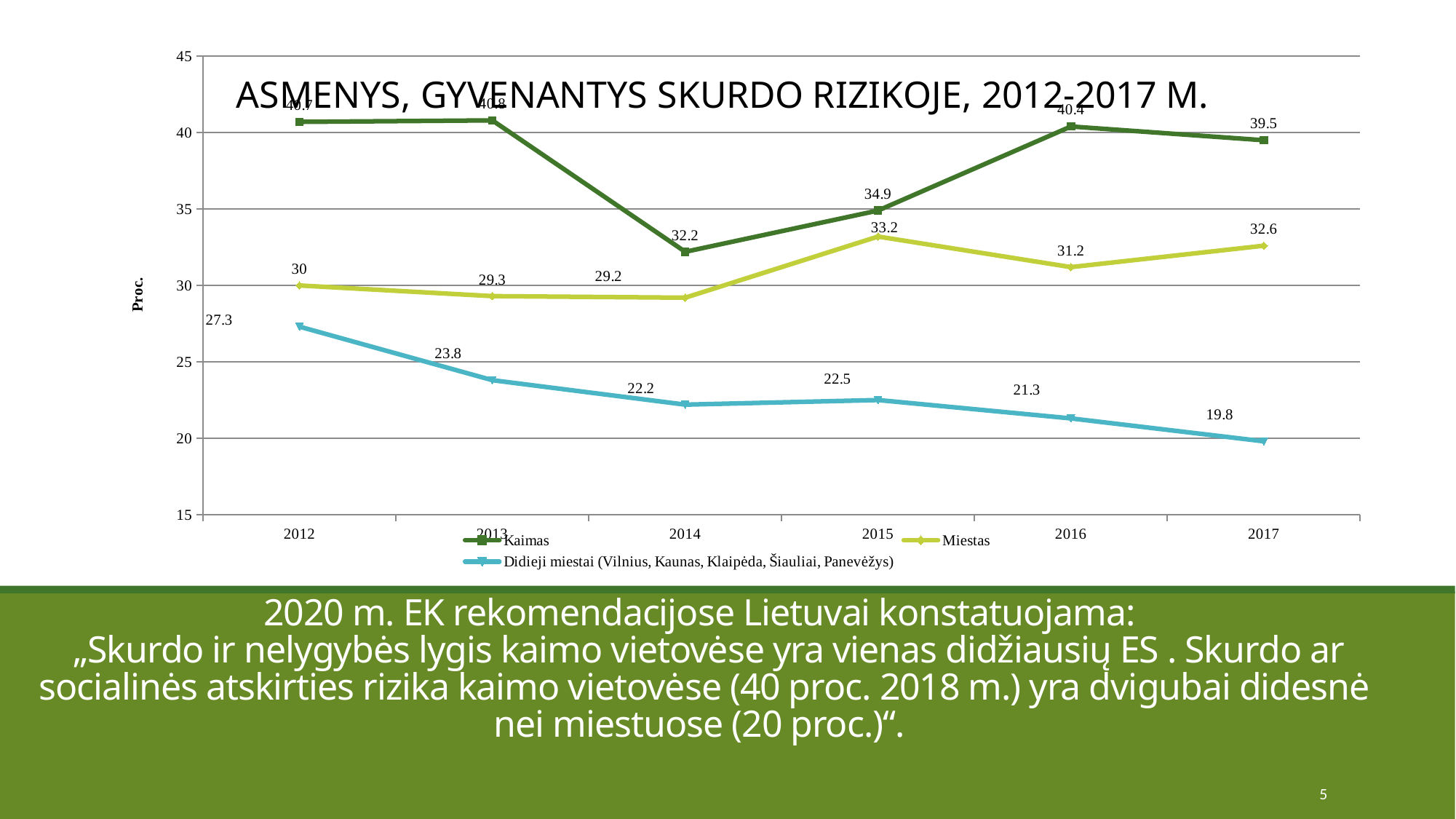
In which year is the Didieji miestai series at its lowest? 2017 How many series does the legend list? 3 What is the value for Kaimas in 2014? 32.2 How many years are shown on the x axis? 6 What type of chart is shown on the slide? line chart What is the value for Didieji miestai in 2017? 19.8 In which year is the Kaimas series at its lowest? 2014 What is the difference between Kaimas and Miestas in 2017? 6.9 What is the value for Miestas in 2015? 33.2 Does the Didieji miestai series generally rise or fall from 2012 to 2017? fall Which is larger in 2016, Miestas or Didieji miestai? Miestas What is the label of the y axis? Proc.